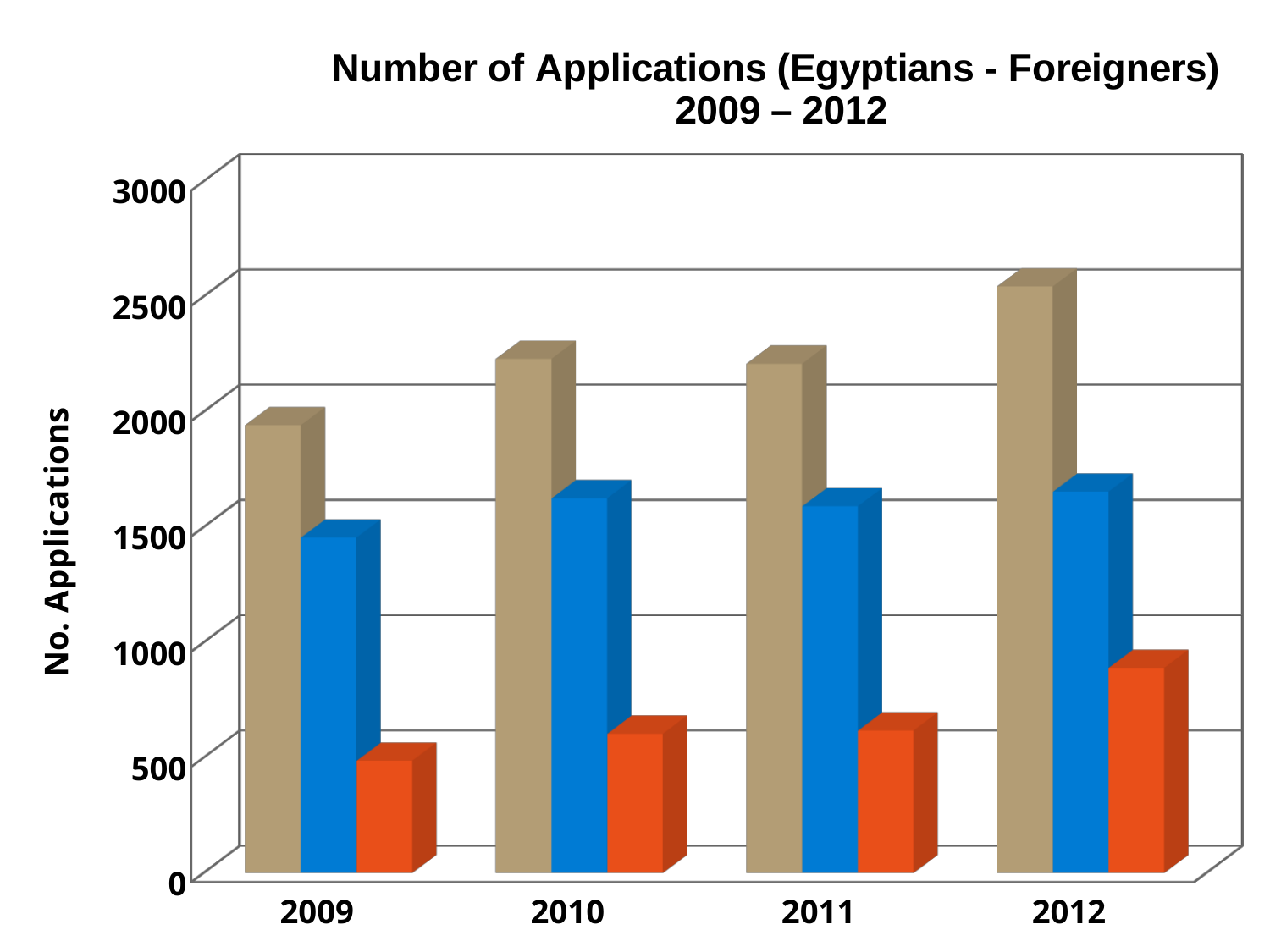
In which year is the tan (first) bar the tallest? 2012 Is the value of the blue bar for 2009 greater or less than 1000? greater In which year is the orange (third) bar the tallest? 2012 Is the value of the blue bar for 2012 greater or less than 1500? greater How many years are shown on the x axis of the chart? 4 In 2011, which bar is taller: the tan bar or the blue bar? the tan bar What is the label on the vertical axis of the chart? No. Applications Is the value of the tan bar for 2010 greater or less than 2000? greater What kind of chart is shown on the slide? bar chart What is the title of the chart? Number of Applications (Egyptians - Foreigners) 2009 – 2012 In which year is the orange (third) bar the shortest? 2009